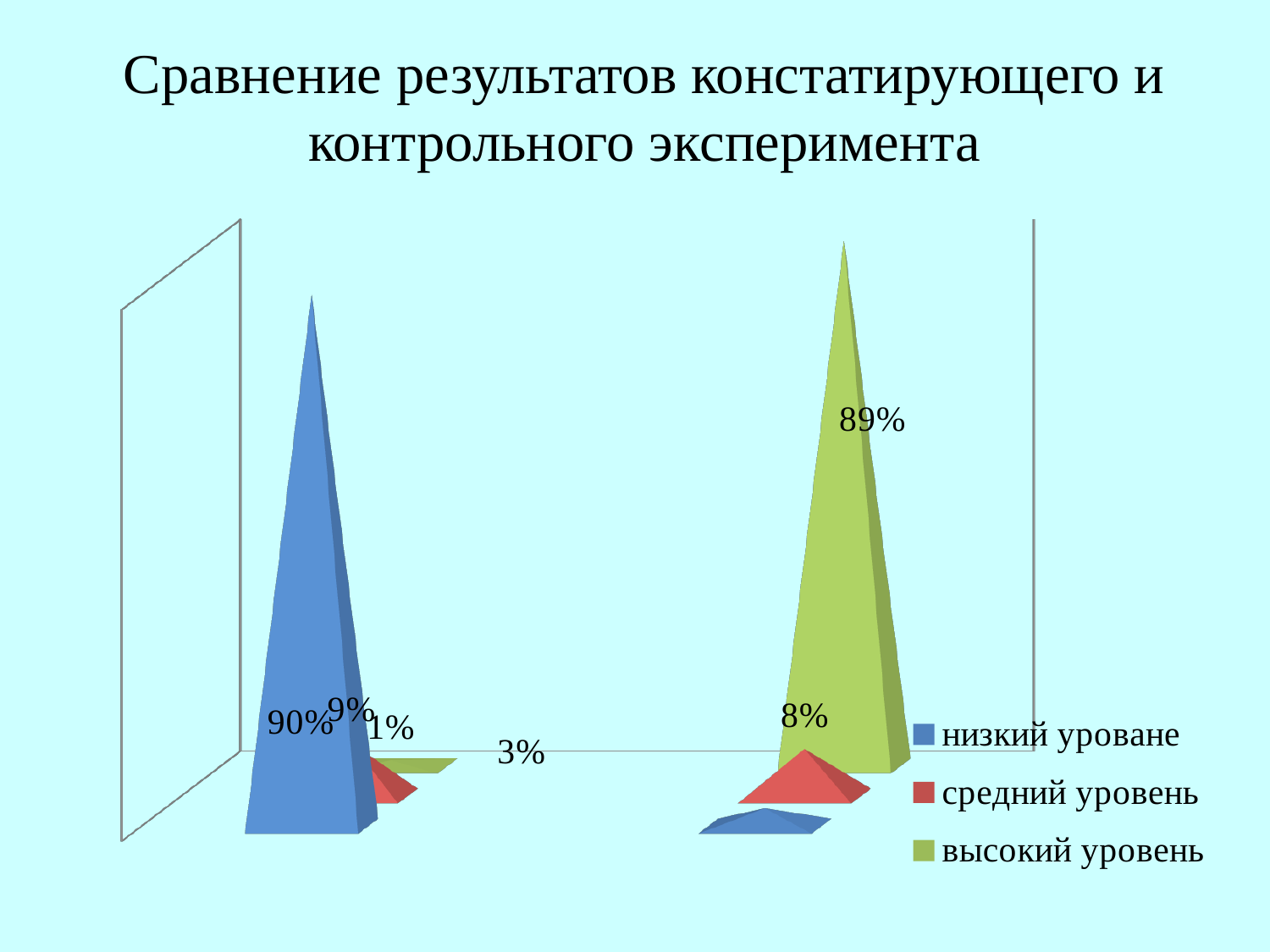
How many groups of bars are plotted on the chart? 2 What is the difference between the низкий уроване value in the left group (90%) and in the right group (3%)? 87% How many series does the legend list? 3 Which colour represents the высокий уровень series in the legend? green What is the value of the низкий уроване series in the right group of bars? 3% What kind of chart is shown on the slide? bar chart What is the value of the высокий уровень series in the right group of bars? 89% What is the value of the высокий уровень series in the left group of bars? 1% What is the value of the средний уровень series in the left group of bars? 9% What is the value of the низкий уроване series in the left group of bars? 90% What is the value of the средний уровень series in the right group of bars? 8% Which series has the highest value in the right group of bars? высокий уровень